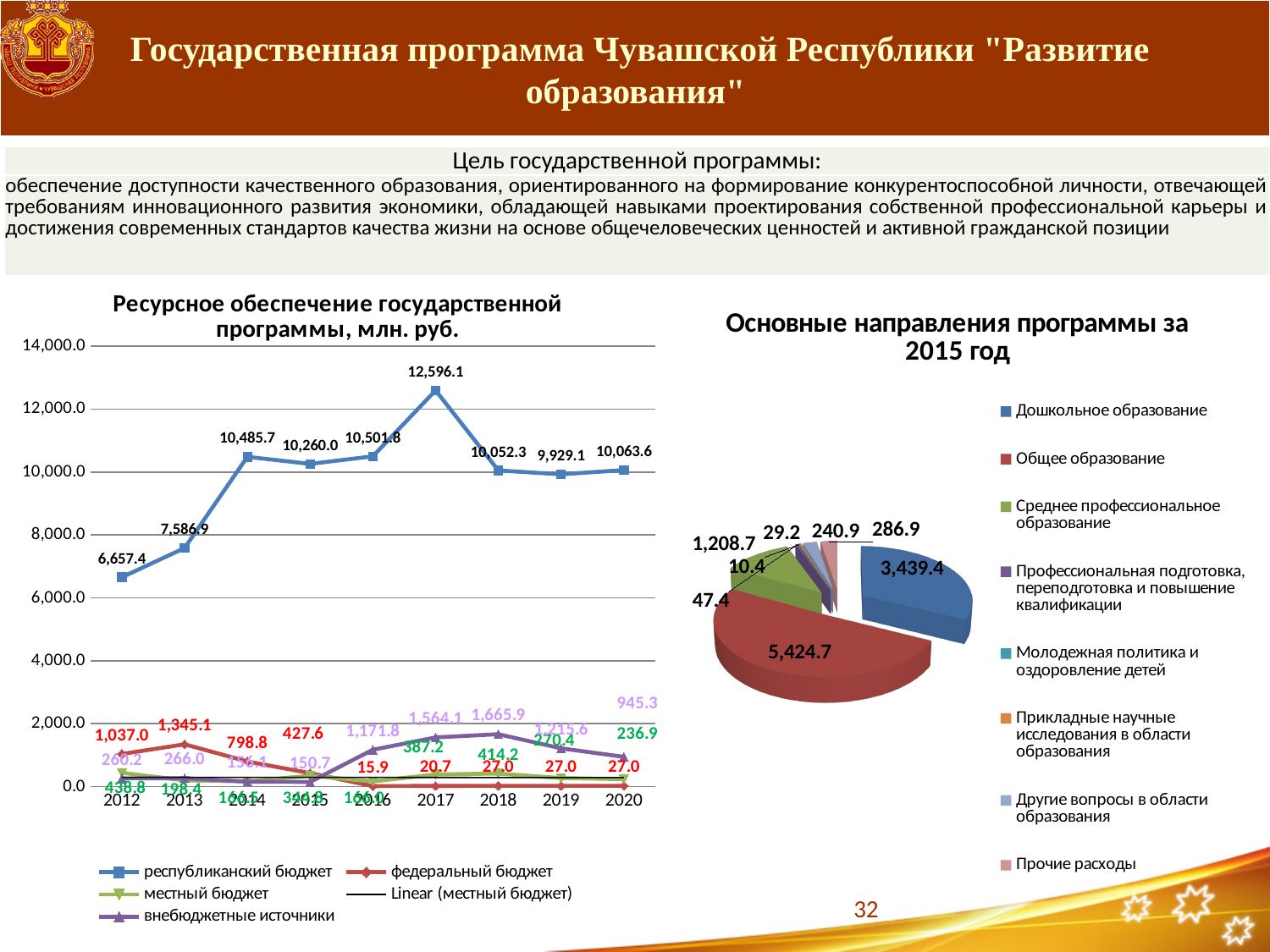
In the 'Ресурсное обеспечение государственной программы' chart, what is the difference between the республиканский бюджет values for 2017 and 2016? 2,094.3 In the 'Ресурсное обеспечение государственной программы' chart, which year has the lowest value for республиканский бюджет? 2012 In the 'Ресурсное обеспечение государственной программы' chart, what is the value of федеральный бюджет in 2013? 1,345.1 How many categories does the legend of the 'Основные направления программы за 2015 год' chart list? 8 In the 'Основные направления программы за 2015 год' chart, which category has the largest slice? Общее образование How many entries does the legend of the 'Ресурсное обеспечение государственной программы' chart list? 5 In the 'Ресурсное обеспечение государственной программы' chart, what is the value of республиканский бюджет in 2017? 12,596.1 In the 'Основные направления программы за 2015 год' chart, what is the value for Дошкольное образование? 3,439.4 In the 'Ресурсное обеспечение государственной программы' chart, which year has the highest value for республиканский бюджет? 2017 In the 'Ресурсное обеспечение государственной программы' chart, how many years are shown on the x axis? 9 In the 'Ресурсное обеспечение государственной программы' chart, which is larger for республиканский бюджет: 2012 or 2013? 2013 What kind of chart is the 'Ресурсное обеспечение государственной программы, млн. руб.' chart? line chart